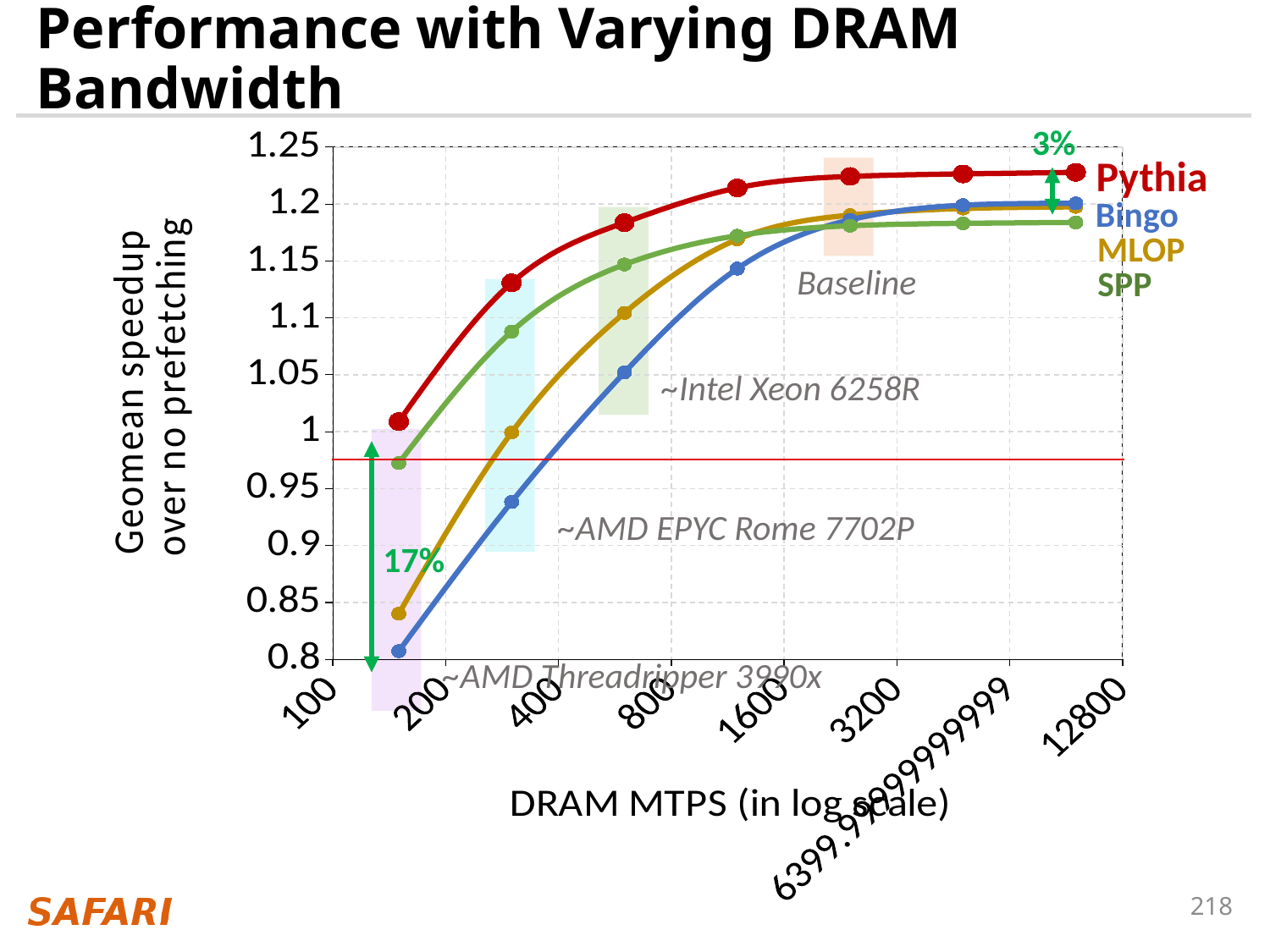
How many series (prefetchers) are plotted in the chart? 4 What percentage improvement is annotated at the lowest DRAM bandwidth point? 17% Which series has the lowest geomean speedup at the lowest DRAM bandwidth point? Bingo Which series has the lowest geomean speedup at the highest DRAM bandwidth point? SPP At the lowest DRAM bandwidth point, which has the higher geomean speedup, SPP or MLOP? SPP What kind of chart is shown on the slide? line chart Which series has the highest geomean speedup at the lowest DRAM bandwidth point? Pythia Is SPP's geomean speedup at the highest DRAM bandwidth point greater or less than 1.2? less Is Pythia's geomean speedup at the highest DRAM bandwidth point greater or less than 1.2? greater How many data points are plotted for each series? 7 Is Bingo's geomean speedup at the lowest DRAM bandwidth point greater or less than 0.85? less Do the geomean speedup values rise or fall as DRAM MTPS increases? rise